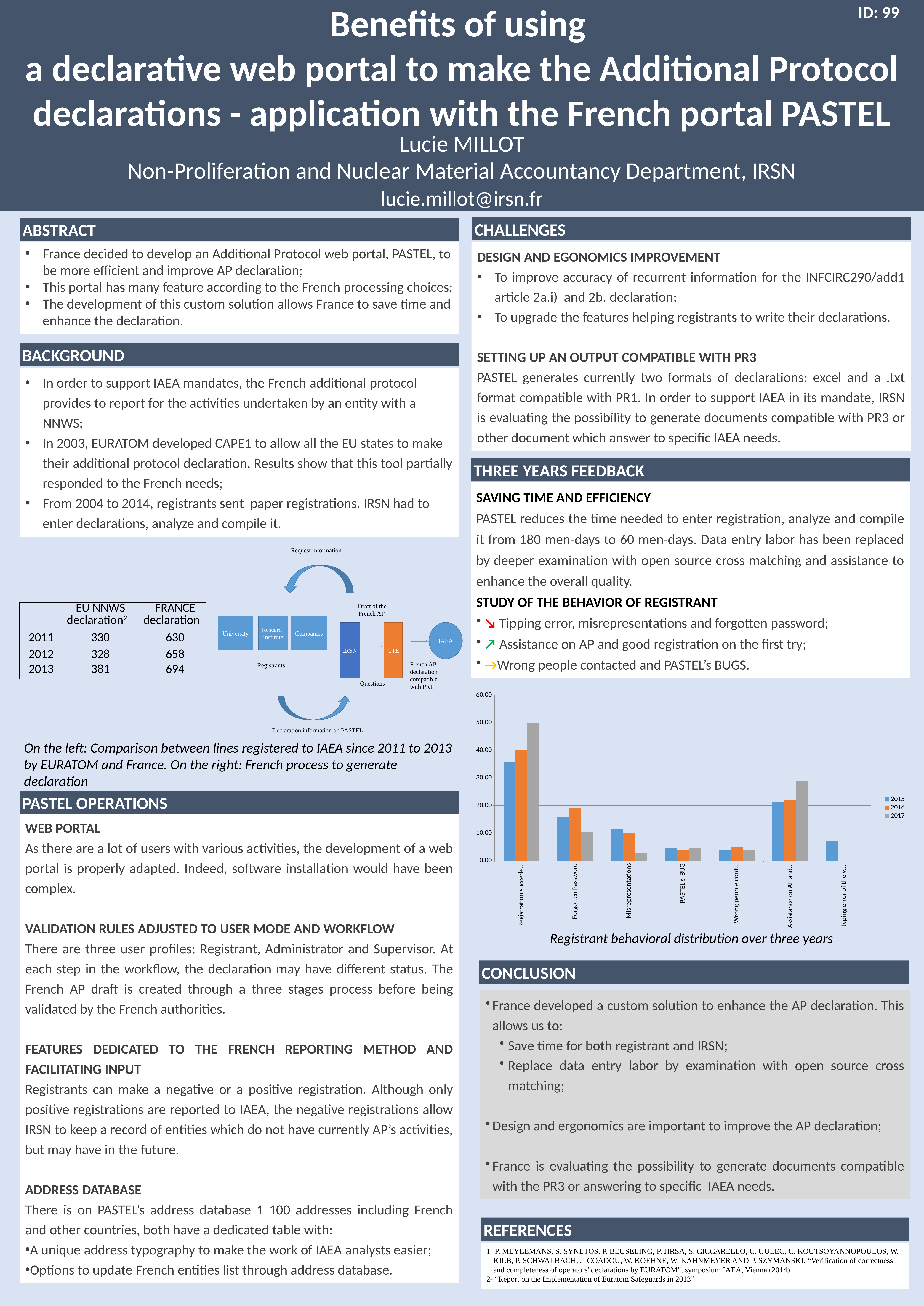
In the registrant behavioral distribution chart, is the 2015 value for Registration succeeded greater or less than 30? greater How many categories are shown on the x axis of the registrant behavioral distribution chart? 7 In the registrant behavioral distribution chart, is the 2017 value for Registration succeeded greater or less than 40? greater In the registrant behavioral distribution chart, which colour represents the 2016 series? orange In the registrant behavioral distribution chart, which is larger for Misrepresentations: the 2015 value or the 2017 value? 2015 In the registrant behavioral distribution chart, which category has the highest value for 2017? Registration succeeded In the registrant behavioral distribution chart, which year has the highest value for Assistance on AP? 2017 In the registrant behavioral distribution chart, which is larger for Forgotten Password: the 2016 value or the 2017 value? 2016 How many series does the legend of the registrant behavioral distribution chart list? 3 What is the caption of the bar chart on the slide? Registrant behavioral distribution over three years In the registrant behavioral distribution chart, is the 2017 value for Forgotten Password greater or less than 20? less What kind of chart is shown under the 'Three years feedback' section? bar chart